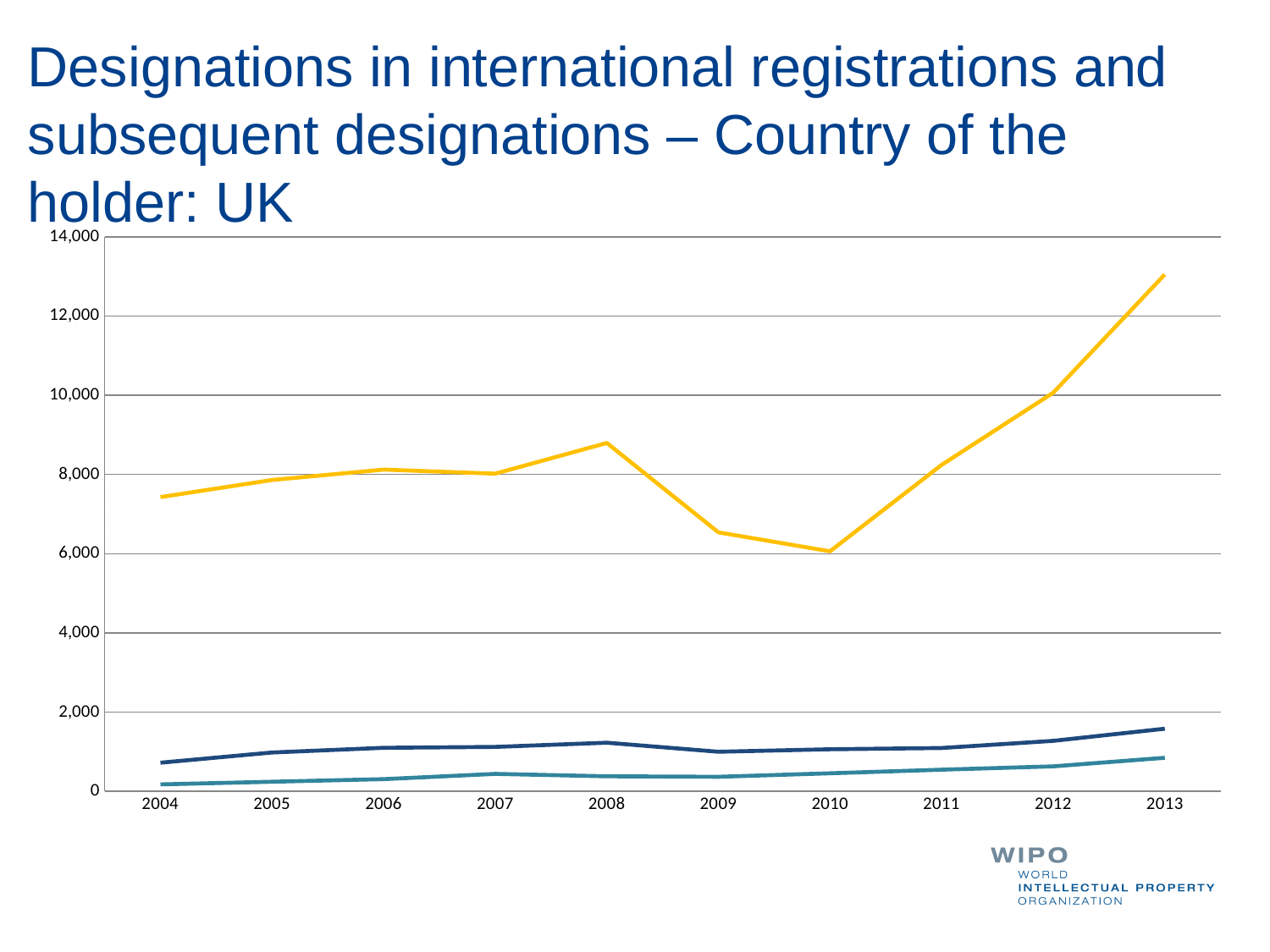
In 2013, which line has the higher value: the dark blue line or the teal line? dark blue line Is the value of the dark blue line in 2013 greater or less than 2,000? less Is the value of the yellow line in 2013 greater or less than 12,000? greater Is the value of the yellow line in 2009 greater or less than 6,000? greater How many lines are plotted on the chart? 3 Which is larger for the yellow line: the value in 2004 or the value in 2013? 2013 What kind of chart is shown on the slide? line chart How many years are shown along the x axis of the chart? 10 In which year does the yellow line reach its lowest value? 2010 Does the yellow line rise or fall between 2010 and 2013? rise In which year does the yellow line reach its highest value? 2013